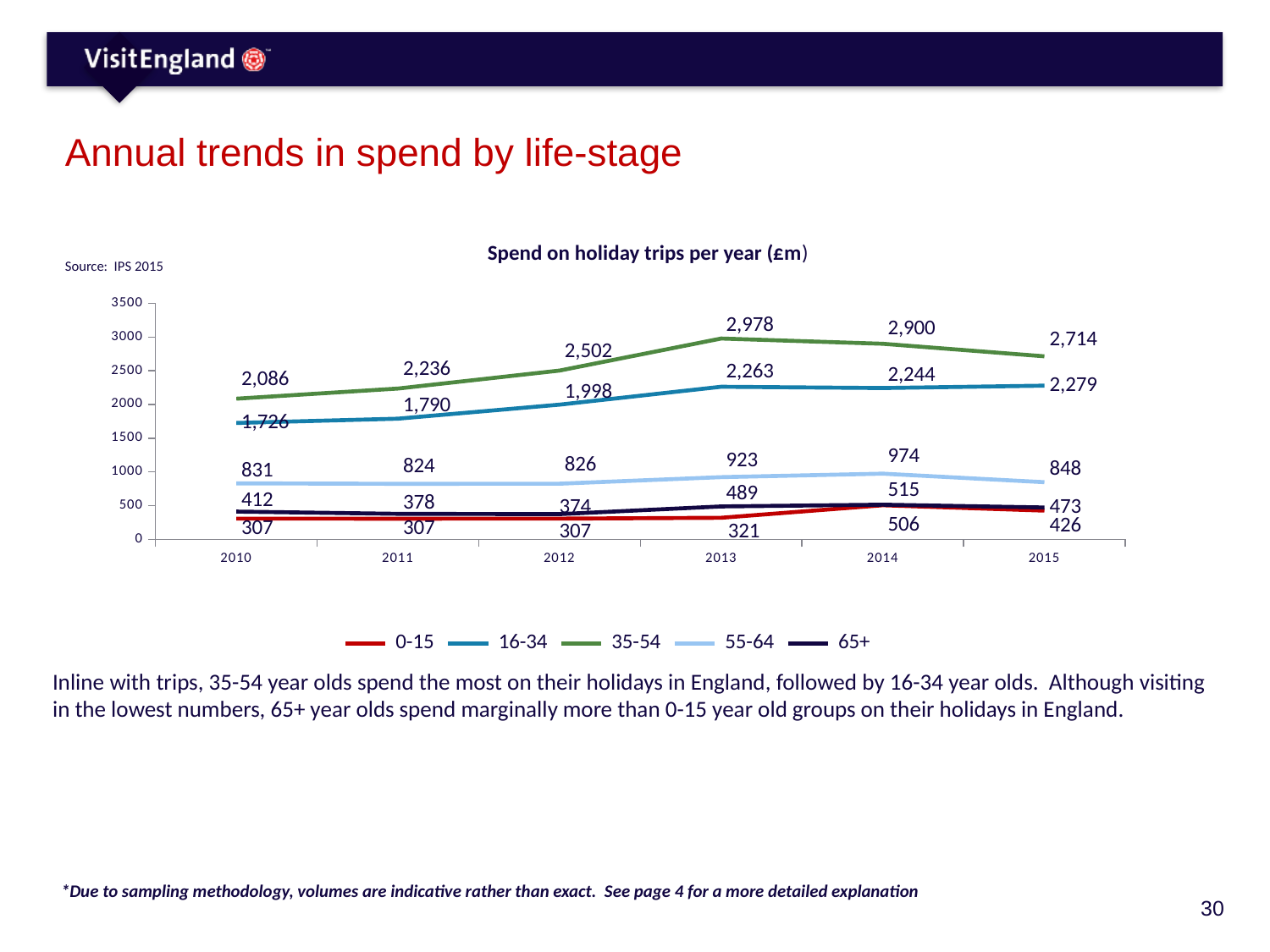
What is the difference between the 35-54 spend and the 16-34 spend in 2015? 435 What is the title of the chart? Spend on holiday trips per year (£m) How many years are shown on the x axis? 6 What type of chart is shown on the slide? line chart In which year was the spend by 35-54 year olds highest? 2013 What was the spend on holiday trips by 35-54 year olds in 2013? 2,978 What was the spend on holiday trips by 55-64 year olds in 2014? 974 In which year was the spend by 65+ year olds lowest? 2012 Which age group spent more in 2012, 55-64 or 65+? 55-64 What was the spend on holiday trips by 16-34 year olds in 2010? 1,726 How many series does the legend list? 5 What was the spend on holiday trips by 0-15 year olds in 2015? 426